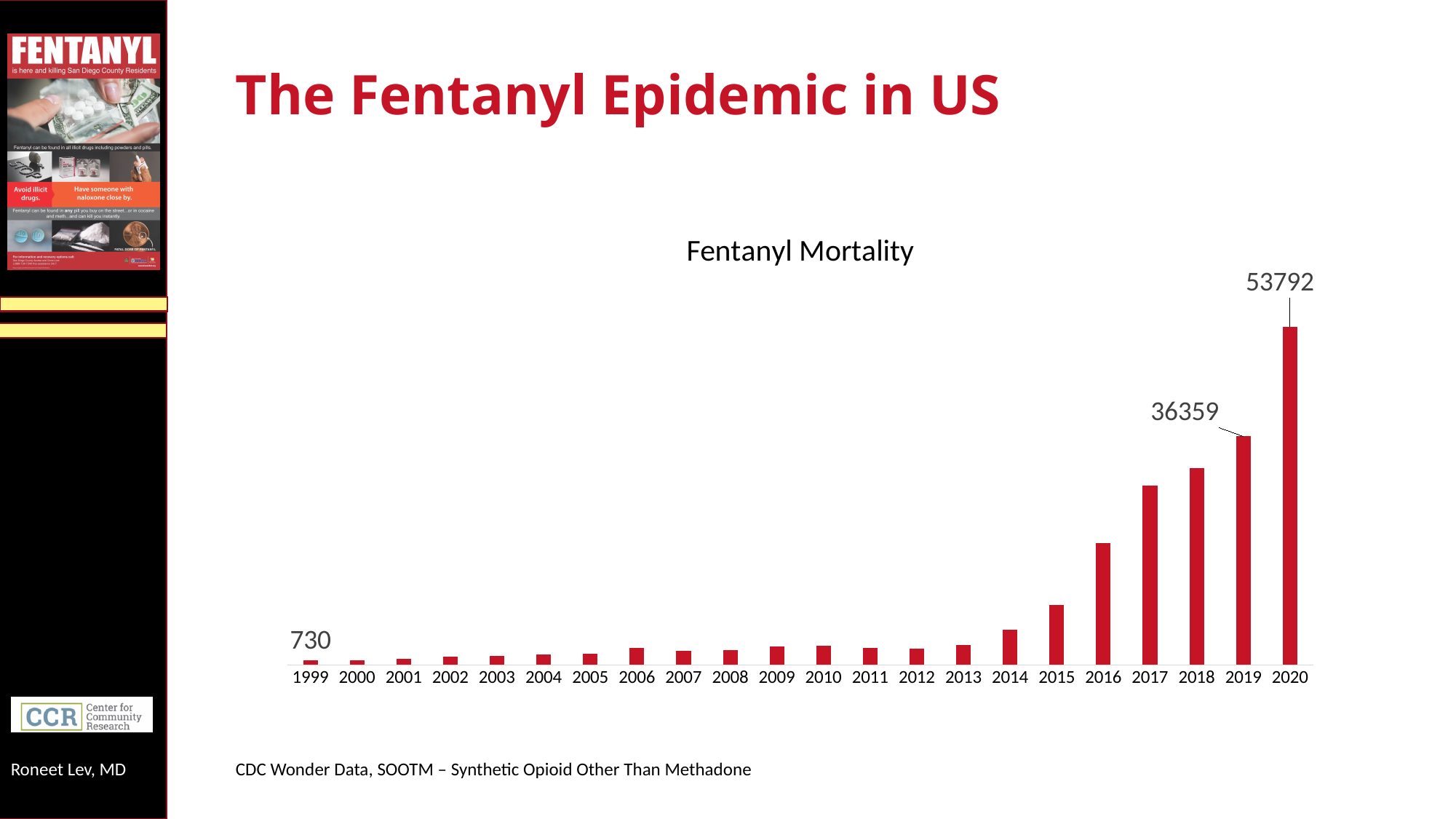
What is the value for 2019 in the Fentanyl Mortality chart? 36359 Which year has the highest value in the Fentanyl Mortality chart? 2020 What is the difference between the values for 2020 and 2019 in the Fentanyl Mortality chart? 17433 Which year has the larger value in the Fentanyl Mortality chart, 2016 or 2014? 2016 What is the value for 1999 in the Fentanyl Mortality chart? 730 What is the title of the chart on the slide? Fentanyl Mortality Which year has the larger value in the Fentanyl Mortality chart, 2018 or 2015? 2018 What is the difference between the values for 2020 and 1999 in the Fentanyl Mortality chart? 53062 How many years are shown on the x axis of the Fentanyl Mortality chart? 22 Do the values in the Fentanyl Mortality chart generally rise or fall from 1999 to 2020? Rise What is the value for 2020 in the Fentanyl Mortality chart? 53792 What kind of chart is the Fentanyl Mortality chart? Bar chart